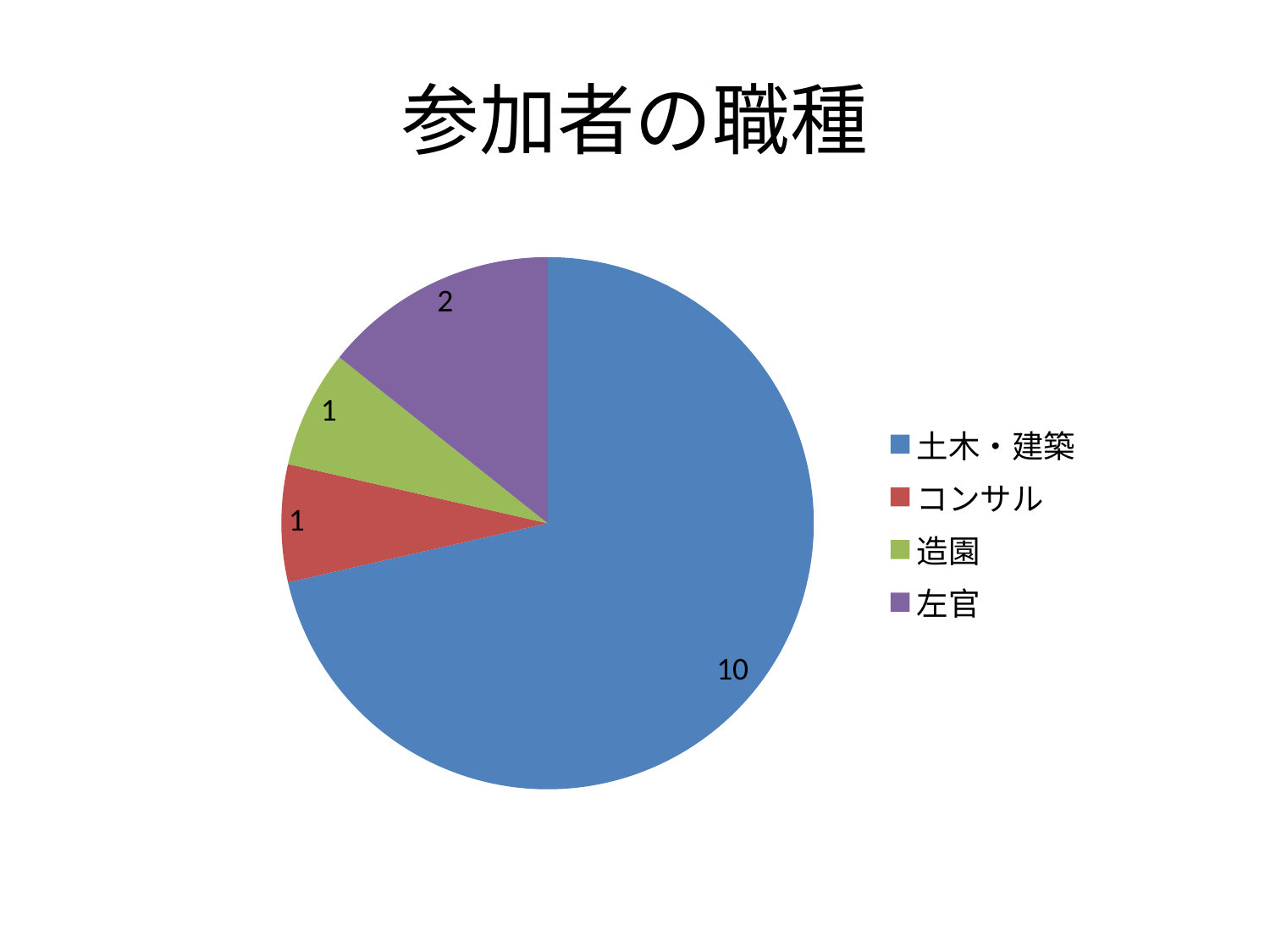
What is the value for コンサル? 1 What is the value for 左官? 2 Which colour represents 造園 in the legend? green What kind of chart is shown on the slide? pie chart What is the difference between the values for 土木・建築 and 左官? 8 How many categories does the pie chart show? 4 What is the value for 土木・建築? 10 What is the total of all slices in the pie chart? 14 What is the value for 造園? 1 Which category has the largest slice? 土木・建築 What is the title of the chart? 参加者の職種 Which is larger, the value for 左官 or the value for 造園? 左官